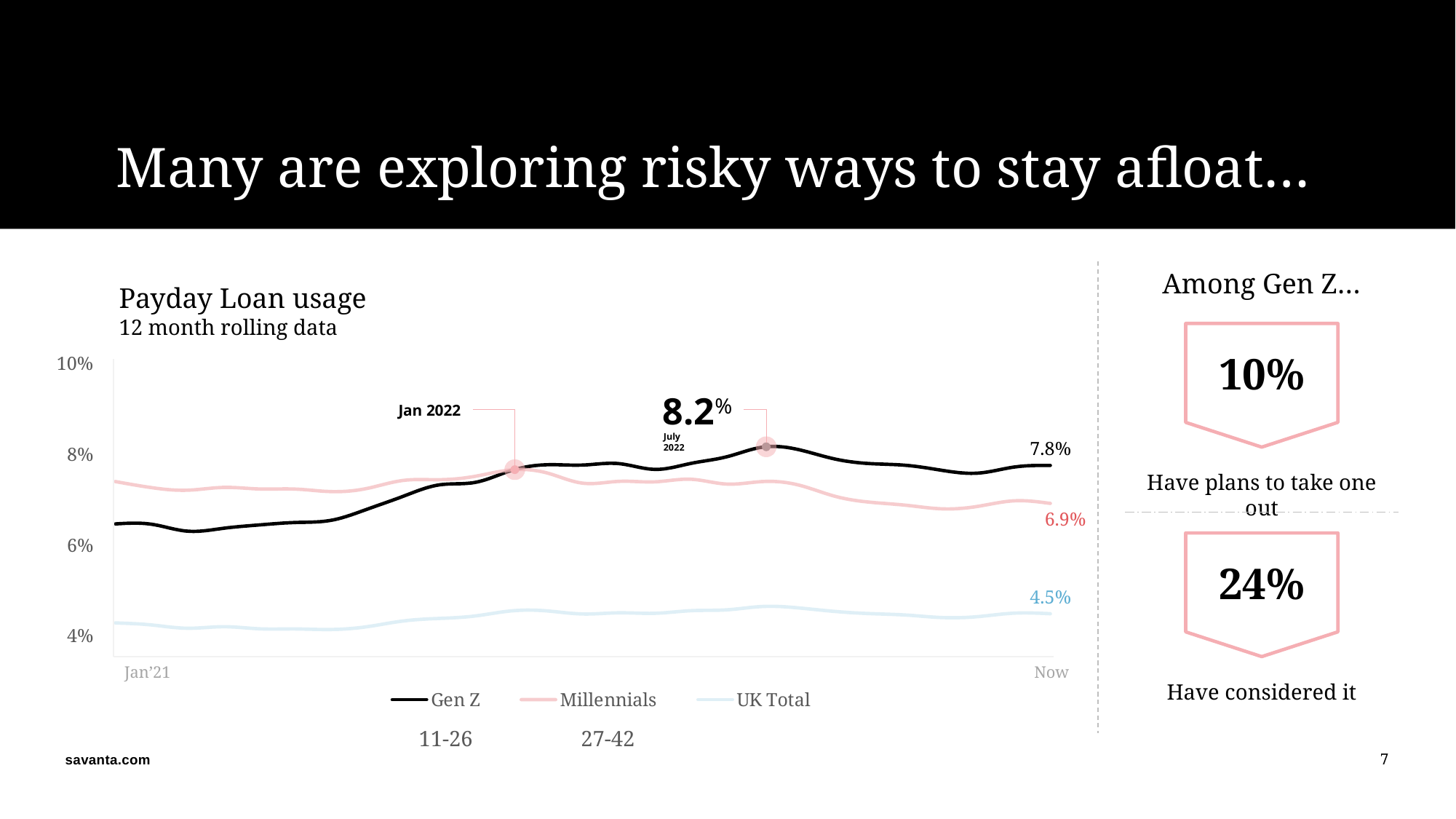
Is the Gen Z value at the start of the chart (Jan'21) greater or less than 8%? less How many series does the legend of the Payday Loan usage chart list? 3 Which series has the lowest value at the end (Now) of the Payday Loan usage chart? UK Total What type of chart is used to show Payday Loan usage? line chart What is the title of the chart on the slide? Payday Loan usage What is the latest (Now) value for Gen Z in the Payday Loan usage chart? 7.8% What was the Gen Z payday loan usage value in July 2022? 8.2% What is the latest (Now) value for UK Total in the Payday Loan usage chart? 4.5% Does the Gen Z line rise or fall overall from Jan'21 to Now in the Payday Loan usage chart? rise What is the difference between the Gen Z and Millennials values at the end (Now) of the Payday Loan usage chart? 0.9% What is the latest (Now) value for Millennials in the Payday Loan usage chart? 6.9% Which series has the highest value at the end (Now) of the Payday Loan usage chart? Gen Z